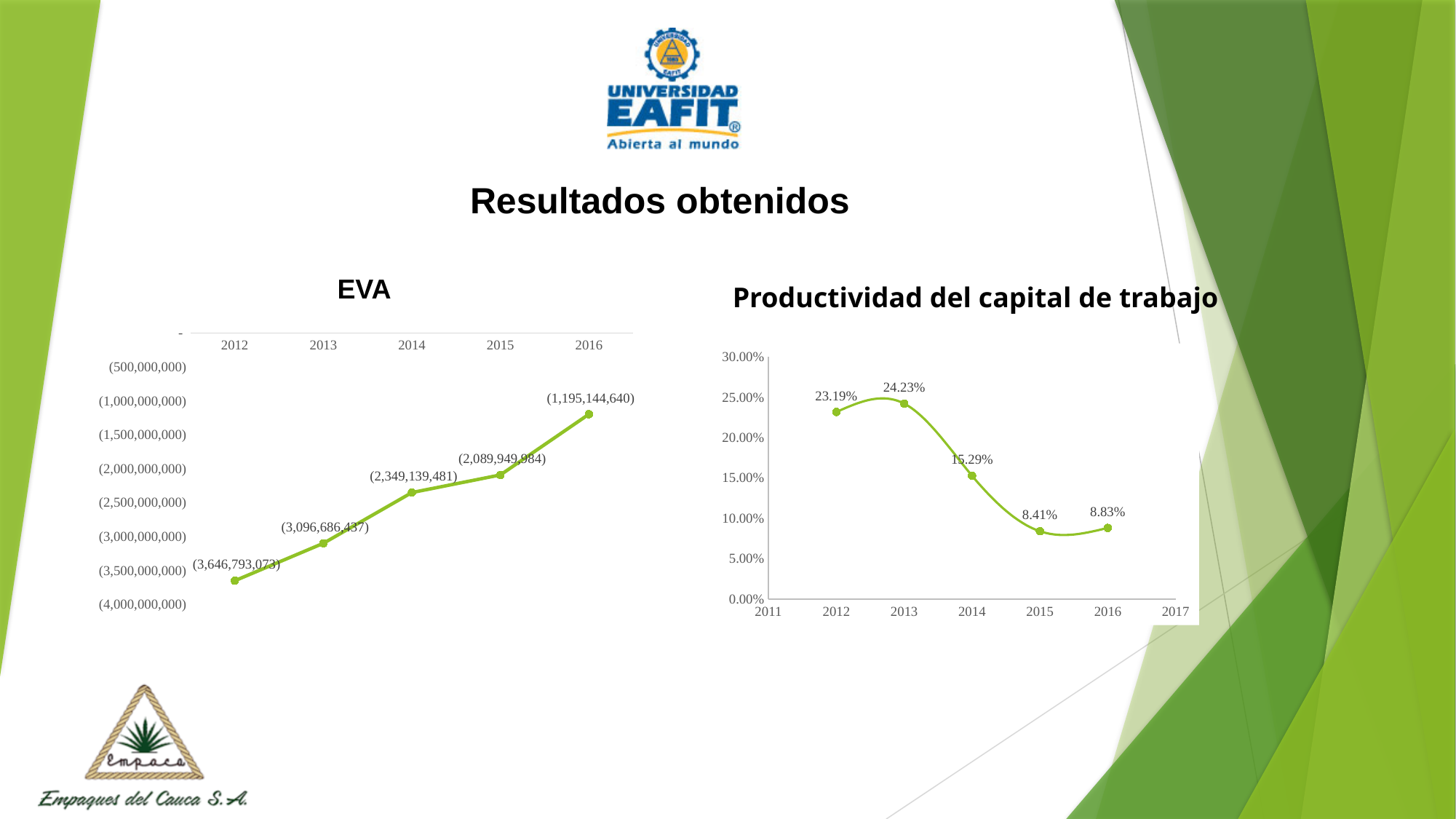
In the EVA chart, what is the value for 2016? (1,195,144,640) In the Productividad del capital de trabajo chart, is the value for 2014 greater or less than 10.00%? greater In the Productividad del capital de trabajo chart, what is the value for 2015? 8.41% What kind of chart is the EVA chart? Line chart In the EVA chart, what is the value for 2015? (2,089,949,984) In the EVA chart, what is the value for 2014? (2,349,139,481) In the Productividad del capital de trabajo chart, which year has the lowest value? 2015 In the Productividad del capital de trabajo chart, what is the difference between the 2013 and 2012 values? 1.04 percentage points In the EVA chart, how many years are plotted? 5 In the EVA chart, do the values rise or fall from 2012 to 2016? Rise In the Productividad del capital de trabajo chart, which year has the highest value? 2013 In the Productividad del capital de trabajo chart, what is the value for 2013? 24.23%